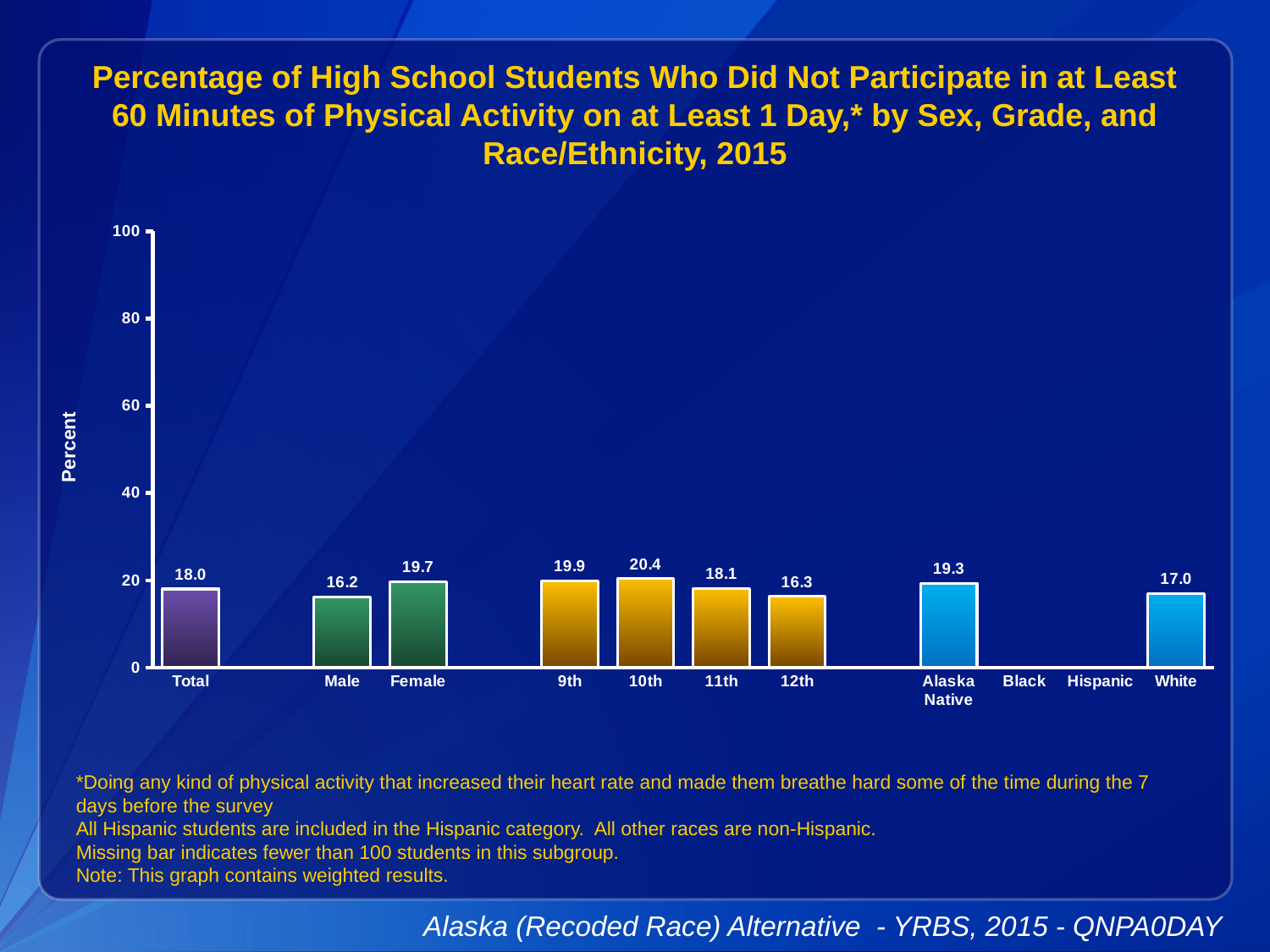
What is the value for Alaska Native? 19.3 Which category has the lowest value among the bars shown? Male Which is larger, the value for 9th grade or the value for 11th grade? 9th Which category has the highest value? 10th What is the difference between the Female and Male values? 3.5 What is the value for Total? 18.0 What kind of chart is shown? bar chart Is the value for White greater or less than 20? less What is the label of the y axis? Percent What is the value for 12th grade? 16.3 What is the value for Female? 19.7 How many bars are plotted on the chart? 9